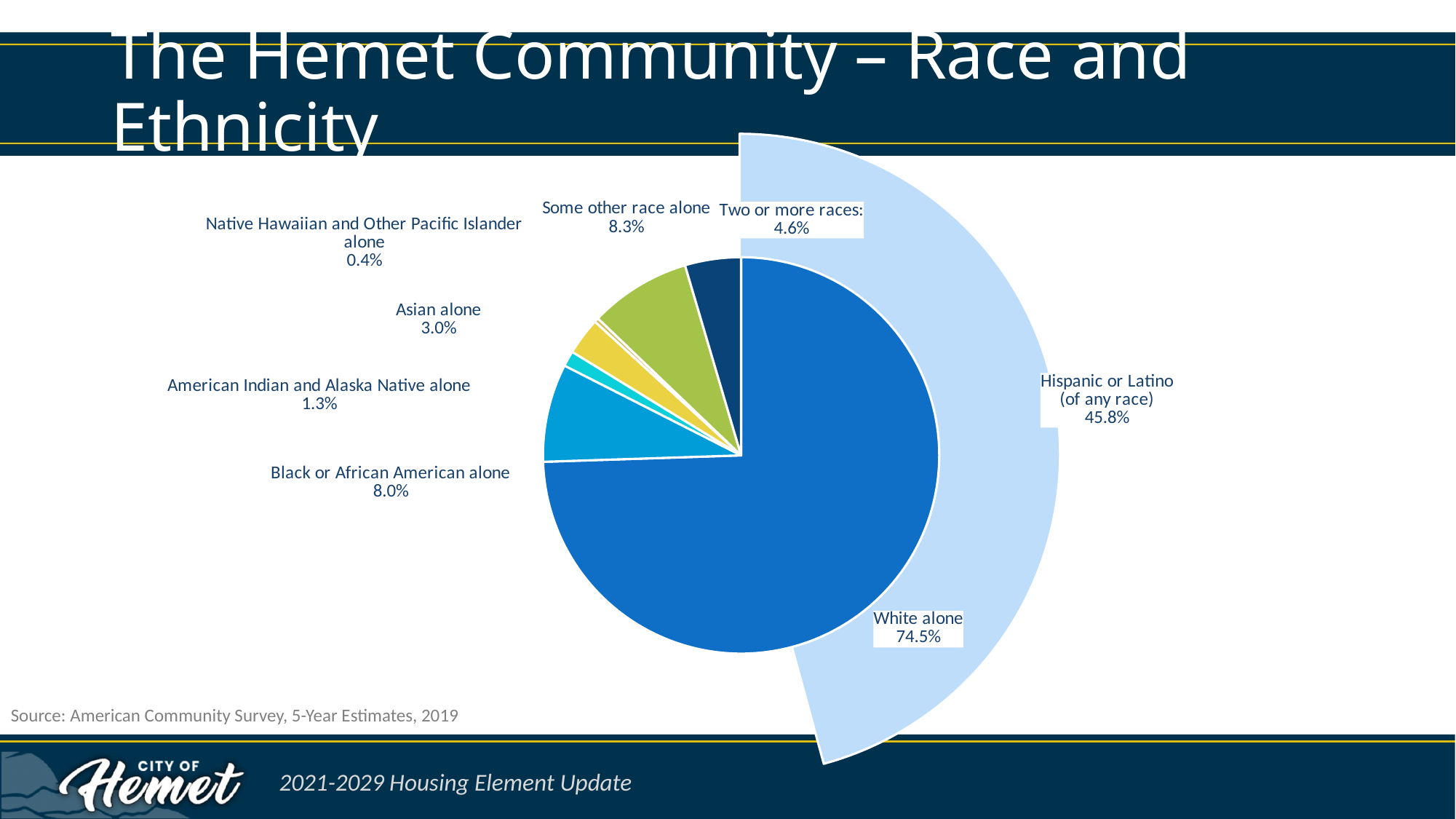
What is the difference in percentage points between White alone and Black or African American alone? 66.5 What share is shown for Hispanic or Latino (of any race)? 45.8% What is the difference in percentage points between Some other race alone and Two or more races? 3.7 What percentage is shown for Two or more races? 4.6% What percentage is shown for Native Hawaiian and Other Pacific Islander alone? 0.4% What percentage of the Hemet community is White alone? 74.5% Which is larger, Some other race alone or Black or African American alone? Some other race alone What kind of chart is shown on the slide? Pie chart Which race category has the smallest labelled percentage? Native Hawaiian and Other Pacific Islander alone Which race category has the largest slice of the pie? White alone What percentage is labelled for Black or African American alone? 8.0% What data source is cited for the chart? American Community Survey, 5-Year Estimates, 2019